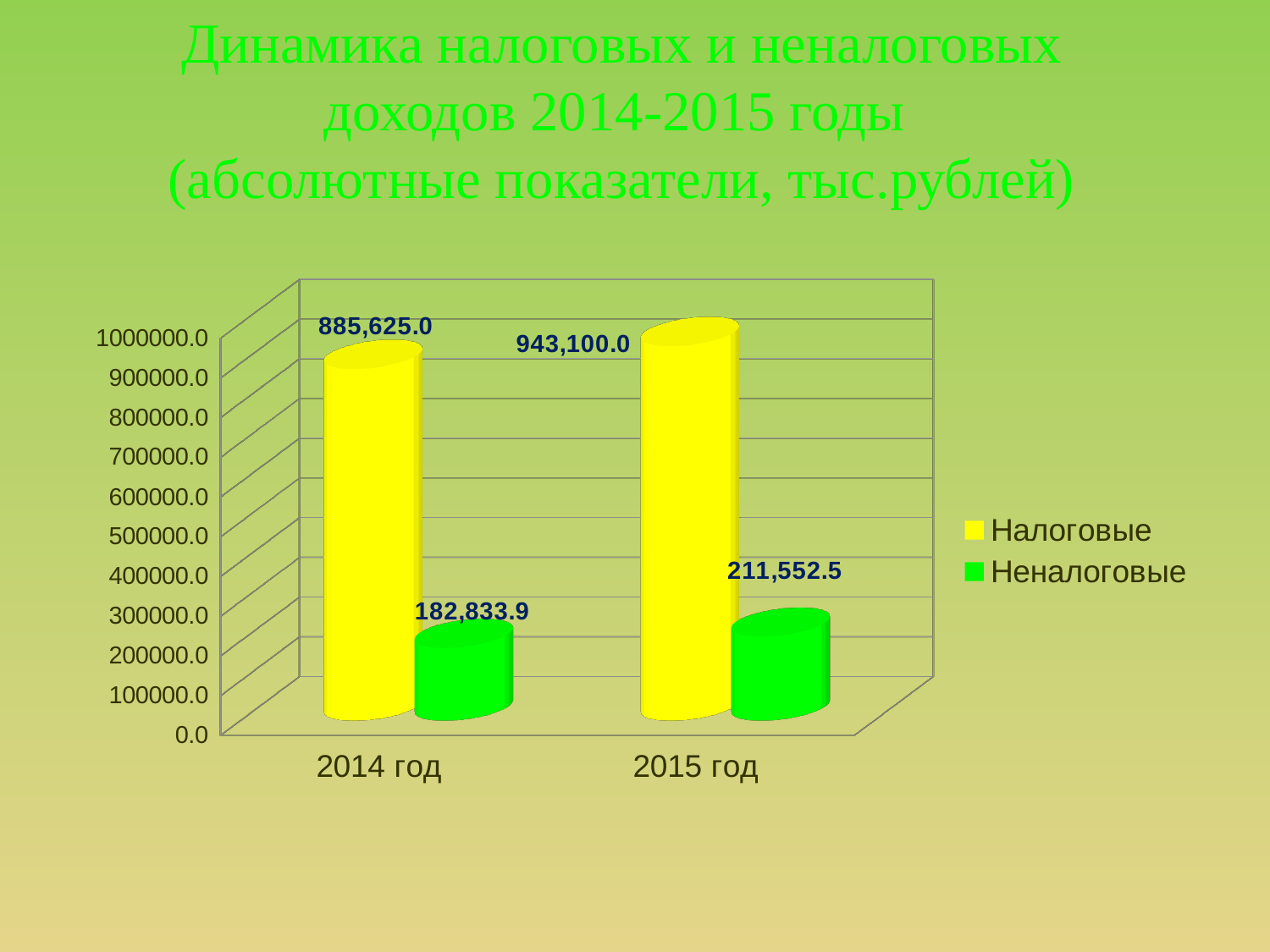
What is the value for Неналоговые in 2014 год? 182,833.9 What is the difference between the Налоговые values for 2015 год and 2014 год? 57,475.0 What is the value for Налоговые in 2015 год? 943,100.0 What is the difference between the Неналоговые values for 2015 год and 2014 год? 28,718.6 How many series does the legend list? 2 Do the Неналоговые values rise or fall from 2014 год to 2015 год? Rise Which year has the higher value for Налоговые? 2015 год What is the value for Неналоговые in 2015 год? 211,552.5 Which is larger in 2015 год: Налоговые or Неналоговые? Налоговые What is the value for Налоговые in 2014 год? 885,625.0 Which bar has the lowest value on the chart? Неналоговые in 2014 год What kind of chart is shown on the slide? Bar chart